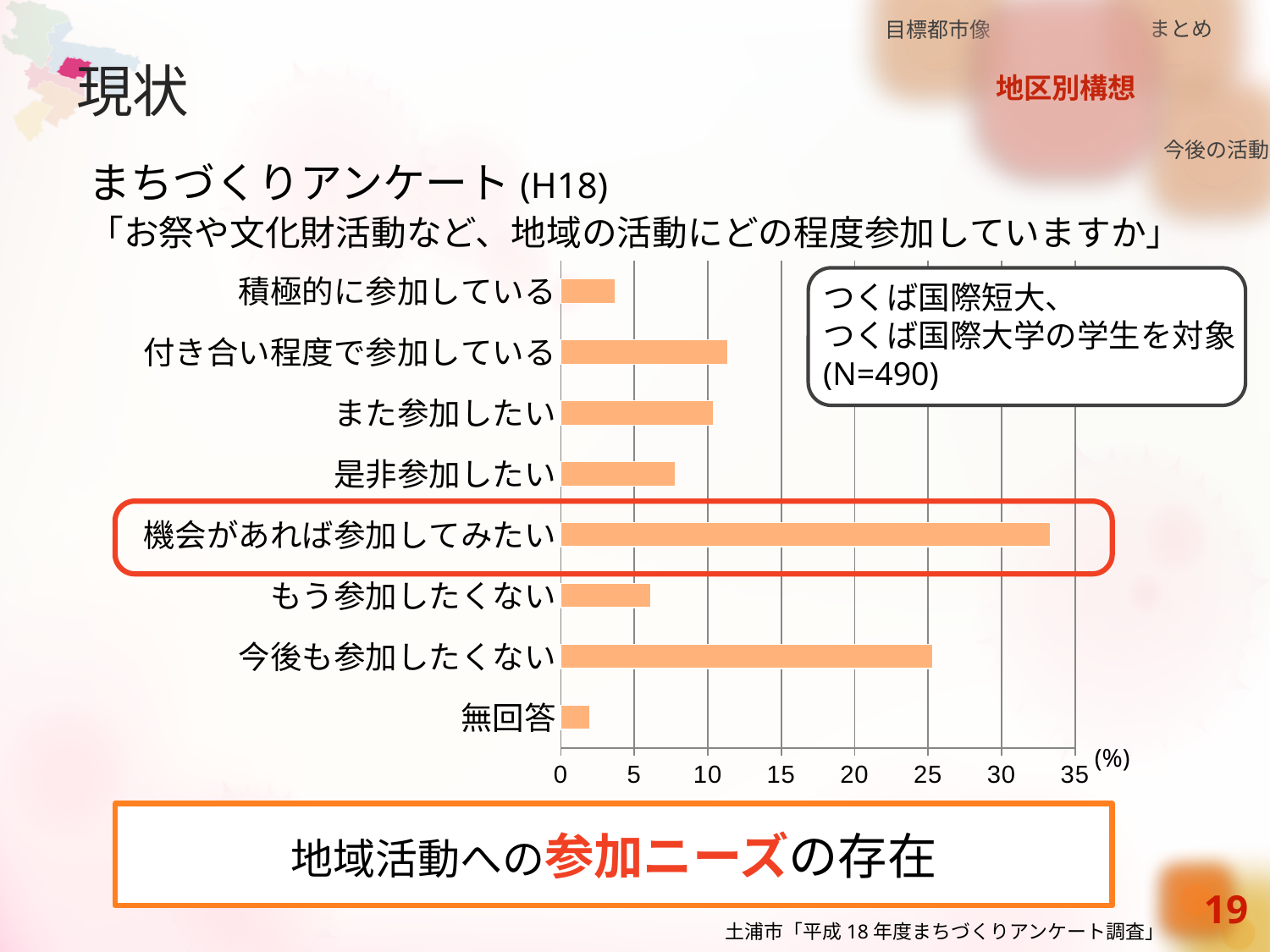
Which category has the lowest value in the chart? 無回答 Which is larger, the value for 今後も参加したくない or the value for 付き合い程度で参加している? 今後も参加したくない Is the value for 付き合い程度で参加している greater or less than 10? greater Is the value for 今後も参加したくない greater or less than 20? greater Is the value for 機会があれば参加してみたい greater or less than 30? greater Which category has the highest value in the chart? 機会があれば参加してみたい What unit is shown at the end of the horizontal axis? (%) What kind of chart is shown on the slide? bar chart Which category is circled in red on the chart? 機会があれば参加してみたい How many categories are plotted in the chart? 8